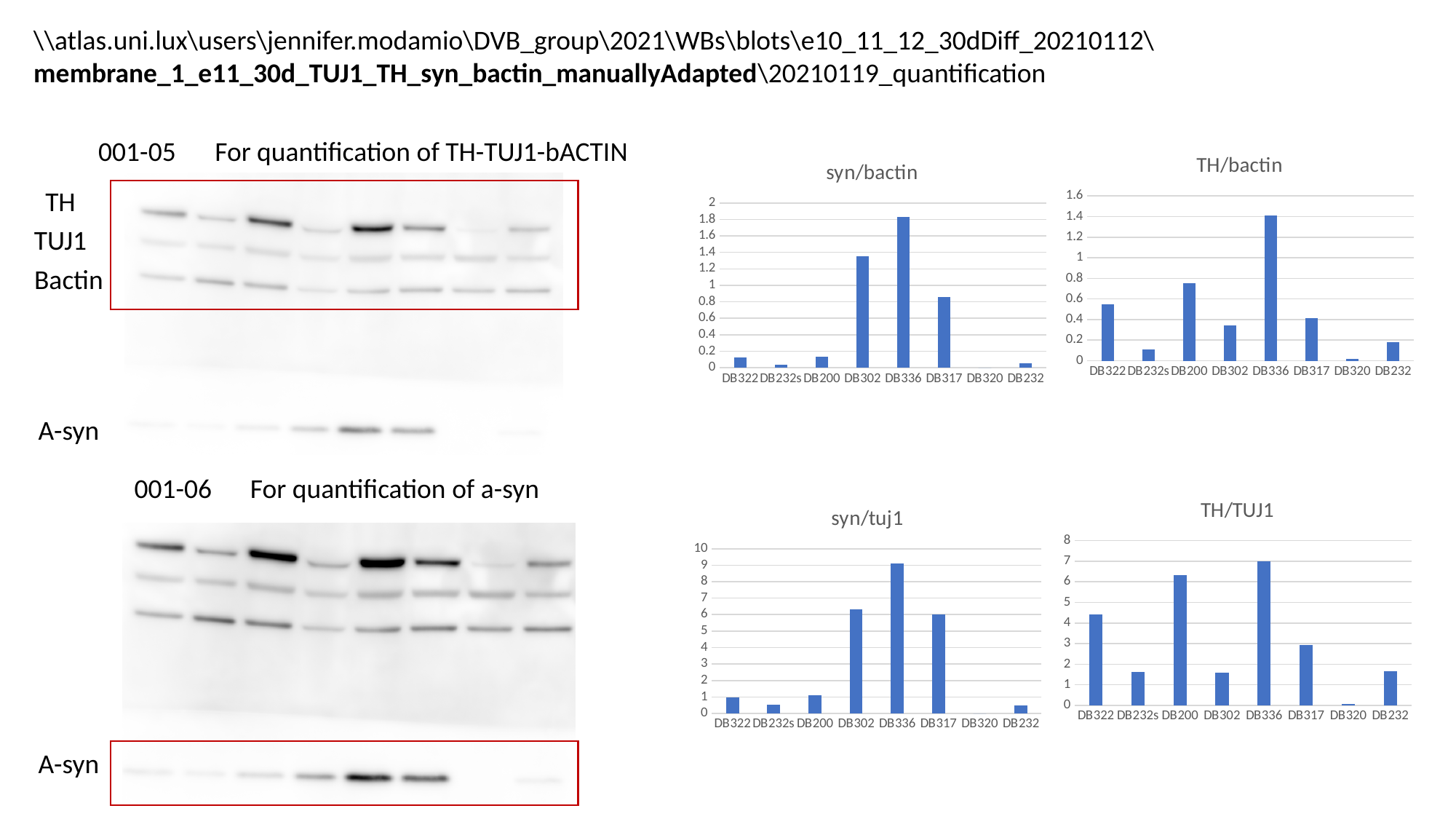
In the syn/bactin chart, is the value for DB302 greater or less than 1? greater In the syn/bactin chart, is the value for DB317 greater or less than 1? less In the TH/TUJ1 chart, which category has the lowest value? DB320 In the syn/tuj1 chart, is the value for DB302 greater or less than 5? greater What kind of chart is the syn/bactin chart? bar chart In the TH/bactin chart, which category has the highest value? DB336 How many categories are shown on the x axis of the TH/TUJ1 chart? 8 In the syn/tuj1 chart, which category has the highest value? DB336 In the TH/bactin chart, which is larger, the value for DB200 or the value for DB317? DB200 In the syn/bactin chart, which category has the highest value? DB336